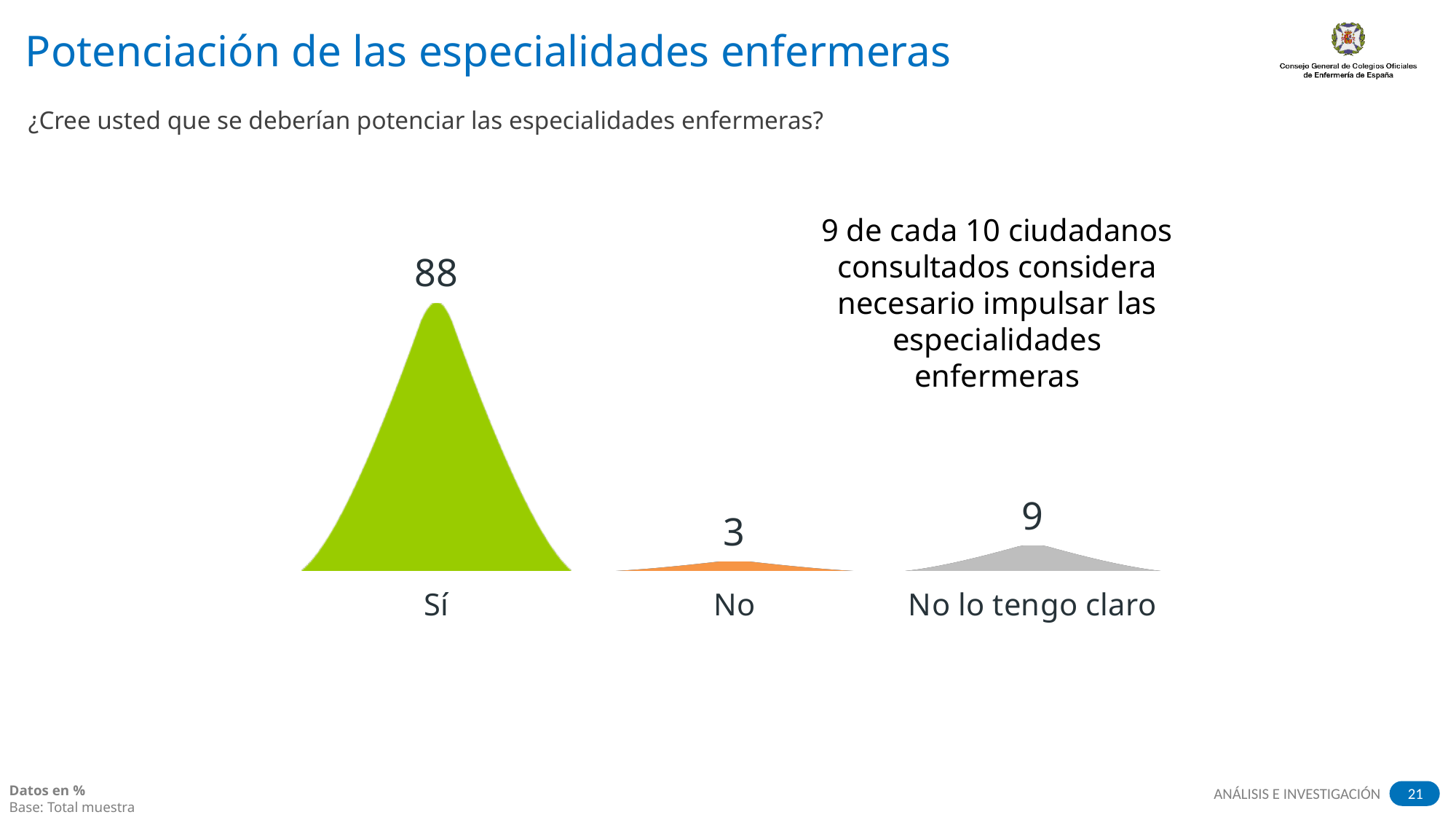
What is the value for "No lo tengo claro"? 9 Which category has the lowest value? No Which is larger, the value for "No" or the value for "No lo tengo claro"? No lo tengo claro Which category has the highest value? Sí What colour is the shape for "Sí"? Green What is the value for "No"? 3 In what unit are the data in the chart expressed, according to the note at the bottom left? % How many categories are shown in the chart? 3 What is the total of the three values shown in the chart? 100 What is the difference between the values for "Sí" and "No lo tengo claro"? 79 What is the difference between the values for "No lo tengo claro" and "No"? 6 What is the value for "Sí"? 88